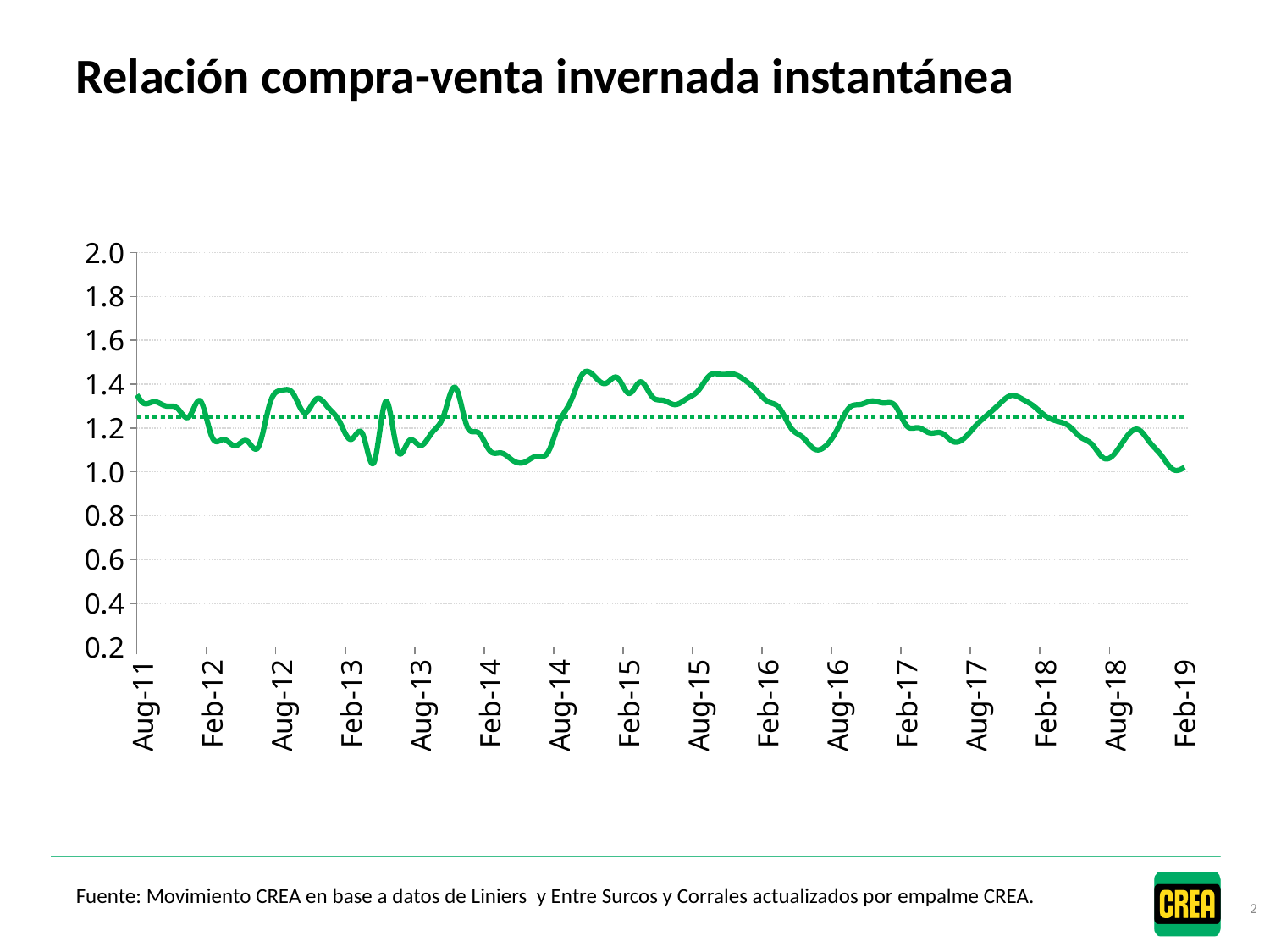
Is the value at Feb-15 greater or less than 1.2? greater Is the value at Feb-19 greater or less than 1.2? less What is the title of the chart? Relación compra-venta invernada instantánea Is the value at Feb-14 greater or less than 1.2? less What is the highest value shown on the y axis? 2.0 What kind of chart is shown on the slide? line chart Does the line rise or fall between Feb-14 and Aug-14? rise Does the line rise or fall overall between Feb-15 and Feb-19? fall How many date labels are shown on the x axis? 16